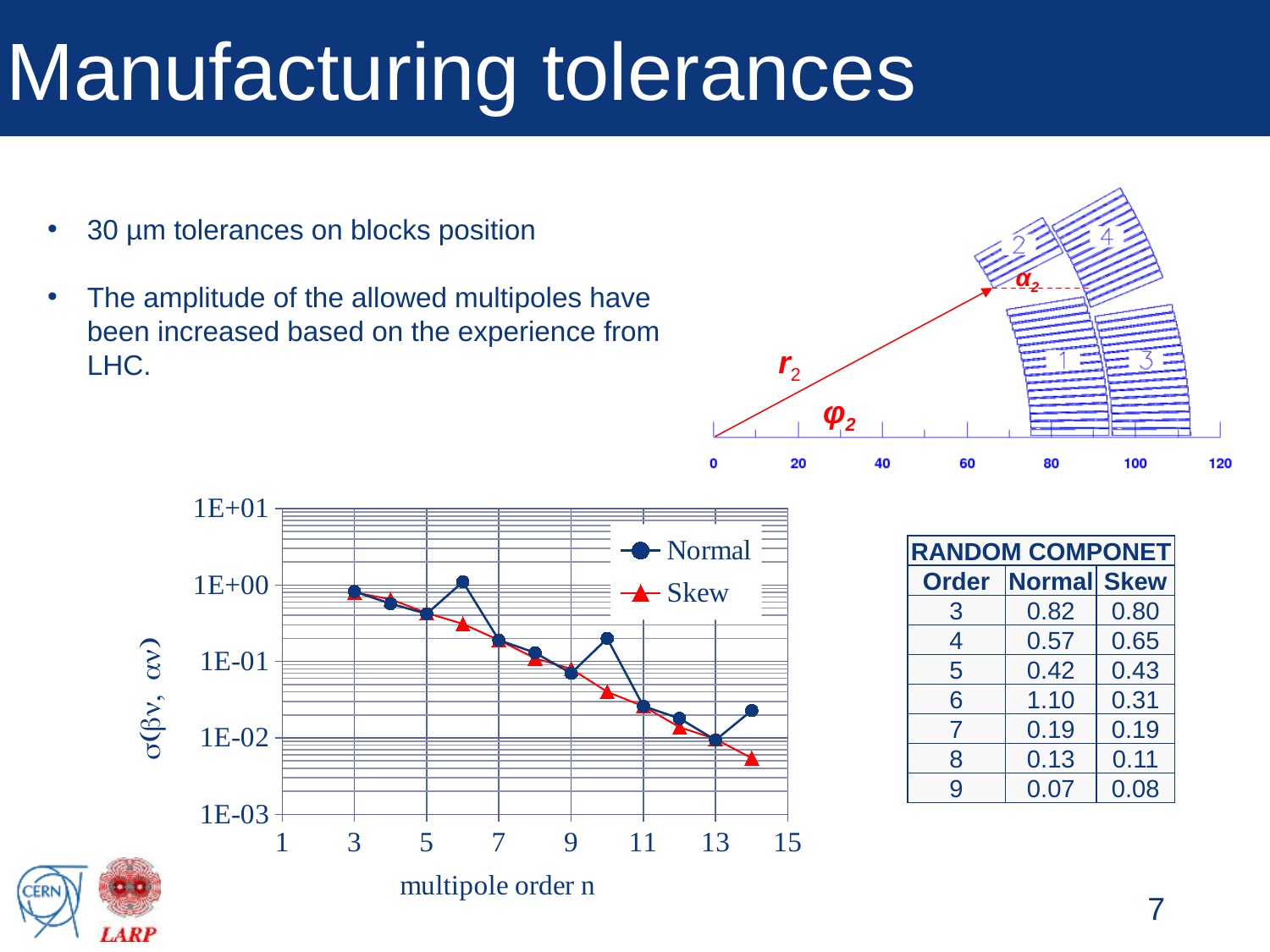
According to the table of random components, what is the Normal value for order 6? 1.10 At multipole order 10, which series has the larger value, Normal or Skew? Normal Is the Normal value at multipole order 6 greater or less than 1E+00? greater Do the Skew values generally rise or fall as the multipole order n increases? fall Is the Skew value at multipole order 14 greater or less than 1E-02? less At which multipole order does the Normal series reach its highest value? 6 Is the Skew value at multipole order 10 greater or less than 1E-01? less What is the label of the x axis of the chart? multipole order n What kind of chart is shown on the slide? line chart How many series does the chart legend list? 2 At which multipole order does the Skew series reach its highest value? 3 Which series in the chart is drawn with red triangle markers? Skew